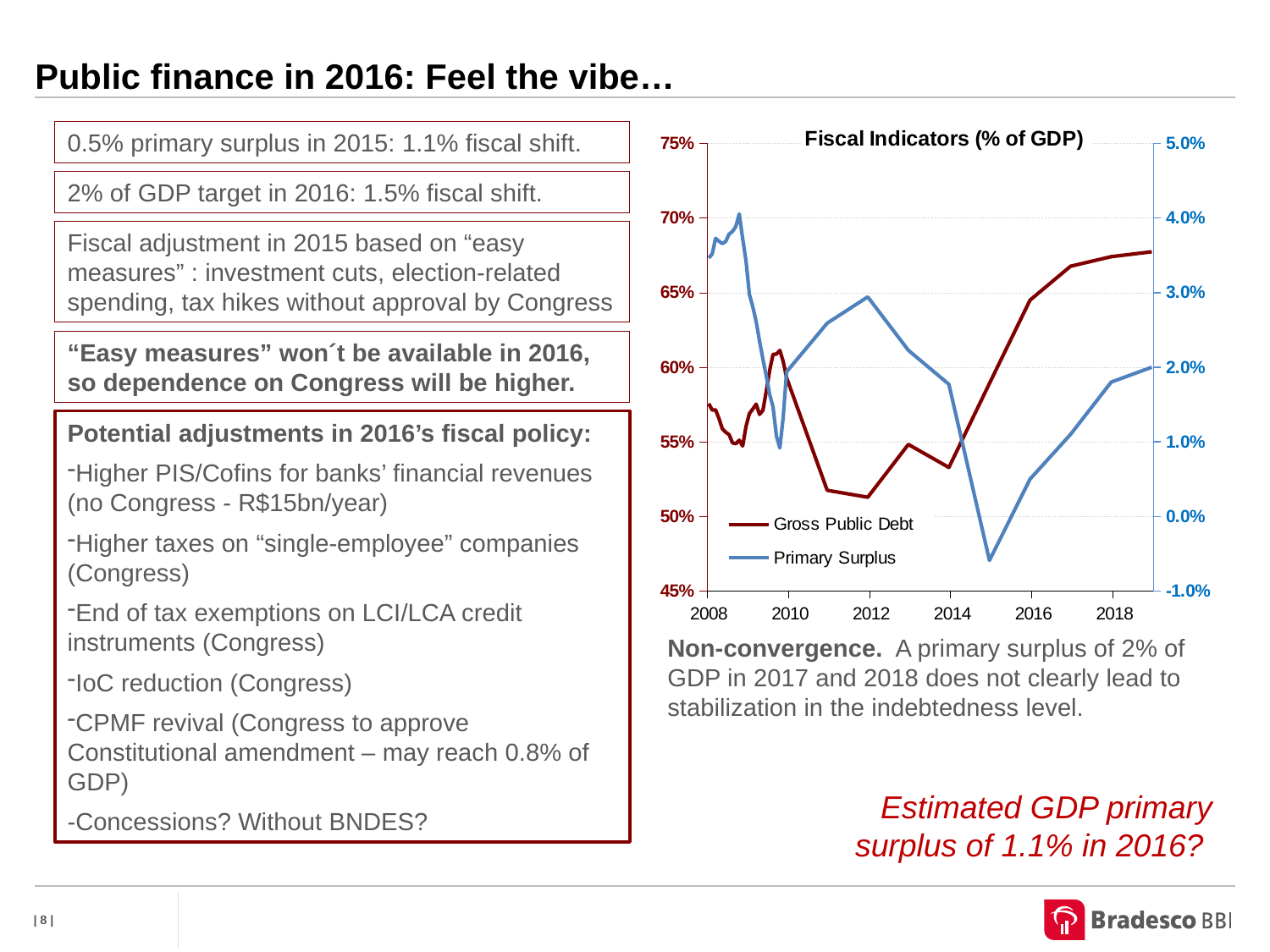
In the Fiscal Indicators chart, in which year does Primary Surplus reach its lowest point? 2015 In the Fiscal Indicators chart, does Primary Surplus rise or fall between 2012 and 2015? Fall In the Fiscal Indicators chart, is the Primary Surplus value in 2012 greater or less than 2.0%? greater How many year labels are shown on the x axis of the Fiscal Indicators chart? 6 In the Fiscal Indicators chart, is the Gross Public Debt value in 2018 greater or less than 65%? greater What kind of chart is the Fiscal Indicators (% of GDP) chart? Line chart In the Fiscal Indicators chart, does Gross Public Debt rise or fall between 2014 and 2018? Rise In the Fiscal Indicators chart, is the Gross Public Debt value in 2012 greater or less than 55%? less Which series in the Fiscal Indicators chart is drawn in dark red? Gross Public Debt How many series does the legend of the Fiscal Indicators chart list? 2 What is the title of the chart on the slide? Fiscal Indicators (% of GDP)